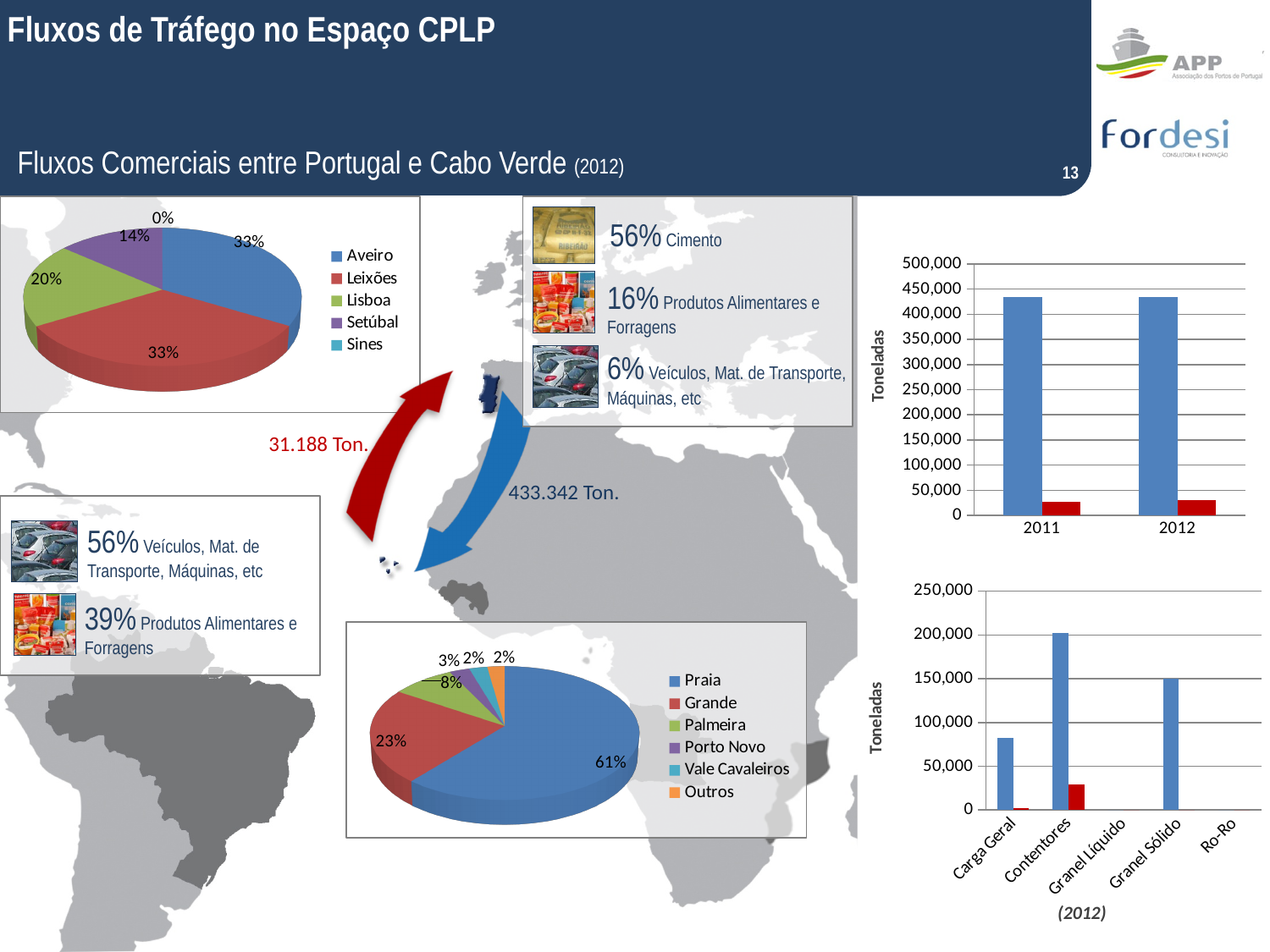
In the bottom-right bar chart, which category has the tallest blue bar? Contentores In the top-left pie chart, what share does Setúbal have? 14% In the bottom-middle pie chart, what share does Praia have? 61% In the top-right bar chart, is the value of the blue bar for 2011 greater or less than 400,000? greater How many categories does the legend of the bottom-middle pie chart list? 6 In the bottom-middle pie chart, what share does Grande have? 23% In the top-left pie chart, which port has the smallest share? Sines In the bottom-middle pie chart, which port has the largest share? Praia In the top-left pie chart, what share does Lisboa have? 20% How many categories does the legend of the top-left pie chart list? 5 In the bottom-middle pie chart, what is the difference between the shares of Praia and Grande? 38% In the bottom-right bar chart, is the blue bar for Granel Sólido greater or less than 100,000? greater